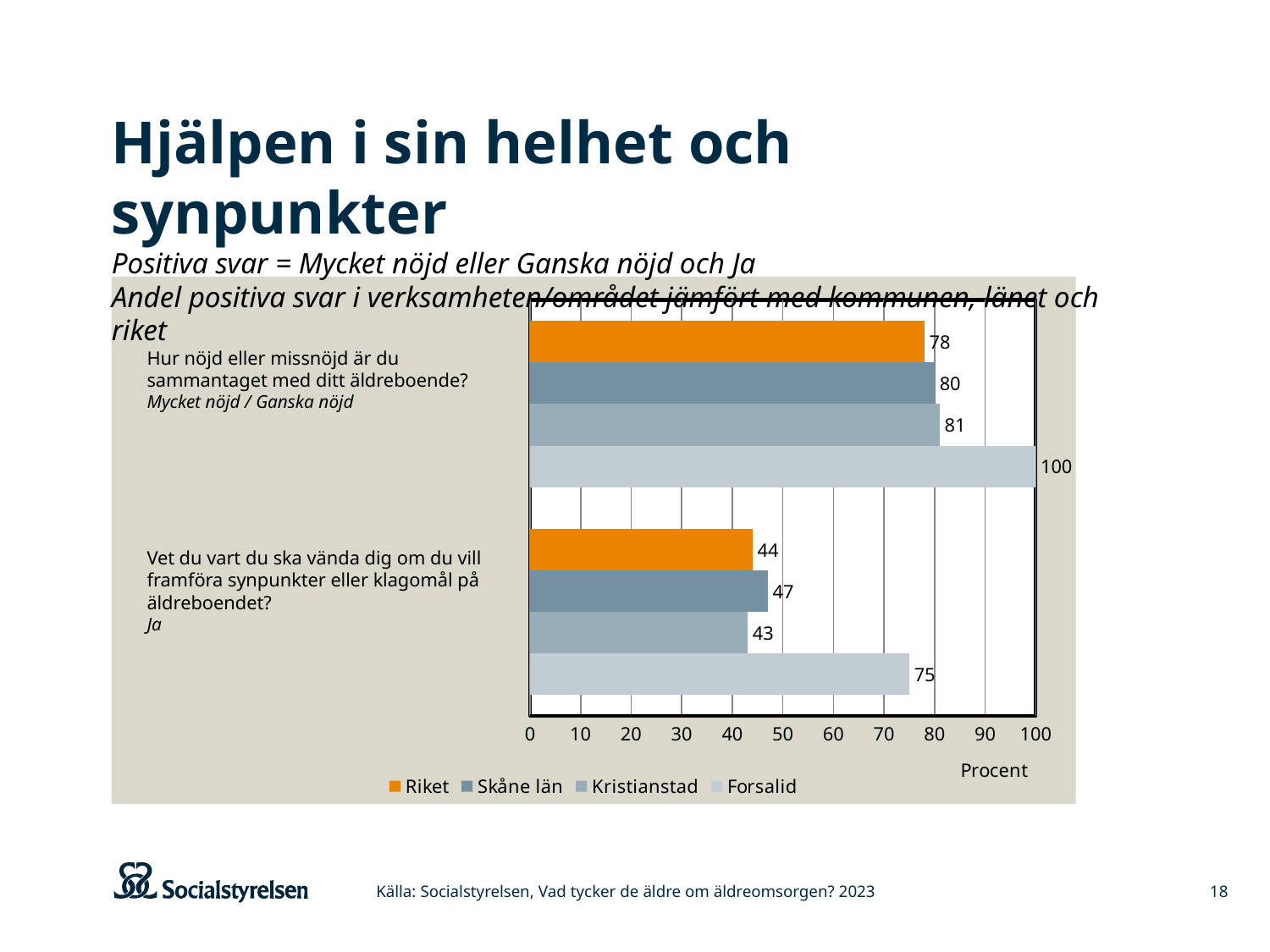
What is the value for Forsalid on the question "Hur nöjd eller missnöjd är du sammantaget med ditt äldreboende?"? 100 What is the label of the x axis? Procent What type of chart is shown on the slide? bar chart How many question categories are shown in the chart? 2 Which is larger on the question "Vet du vart du ska vända dig om du vill framföra synpunkter eller klagomål på äldreboendet?": Skåne län or Kristianstad? Skåne län How many series does the legend list? 4 What is the value for Skåne län on the question "Vet du vart du ska vända dig om du vill framföra synpunkter eller klagomål på äldreboendet?"? 47 What is the difference between Forsalid and Riket on the question "Vet du vart du ska vända dig om du vill framföra synpunkter eller klagomål på äldreboendet?"? 31 What is the value for Riket on the question "Vet du vart du ska vända dig om du vill framföra synpunkter eller klagomål på äldreboendet?"? 44 Which series has the highest value on the question "Vet du vart du ska vända dig om du vill framföra synpunkter eller klagomål på äldreboendet?"? Forsalid What is the value for Kristianstad on the question "Hur nöjd eller missnöjd är du sammantaget med ditt äldreboende?"? 81 Which series has the lowest value on the question "Hur nöjd eller missnöjd är du sammantaget med ditt äldreboende?"? Riket